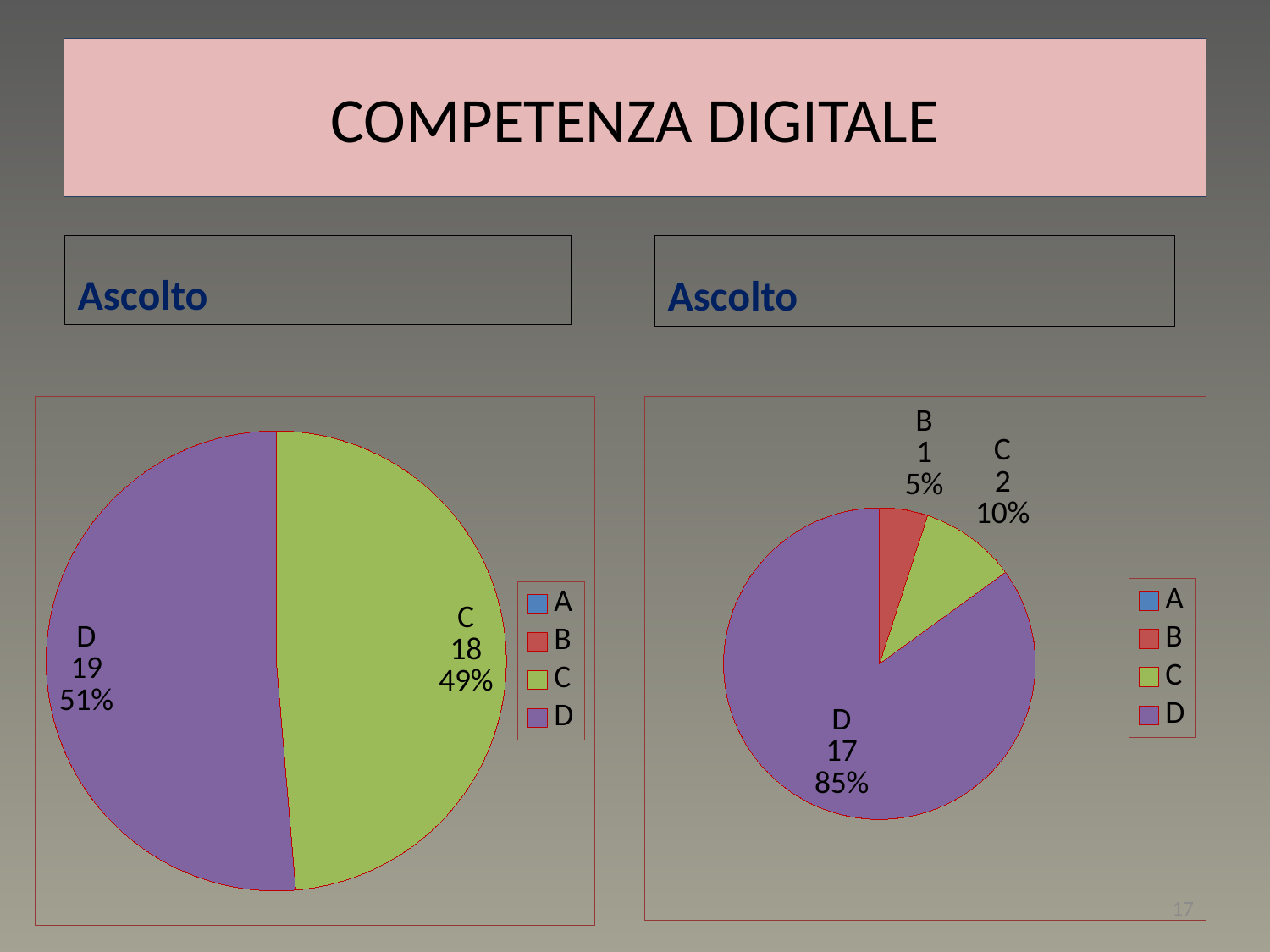
In the right pie chart, what share of the pie does category B have? 5% How many entries does the legend of the right pie chart list? 4 In the right pie chart, what is the value for category C? 2 In the left pie chart, which category has the largest slice? D In the right pie chart, which is larger, the value for C or the value for B? C In the left pie chart, what share of the pie does category C have? 49% In the right pie chart, what is the value for category D? 17 In the right pie chart, which labelled category has the smallest slice? B What colour is category D in the left pie chart? purple In the left pie chart, what is the difference between the values for D and C? 1 What kind of chart is the left chart on the slide? pie chart In the left pie chart, what is the value for category D? 19